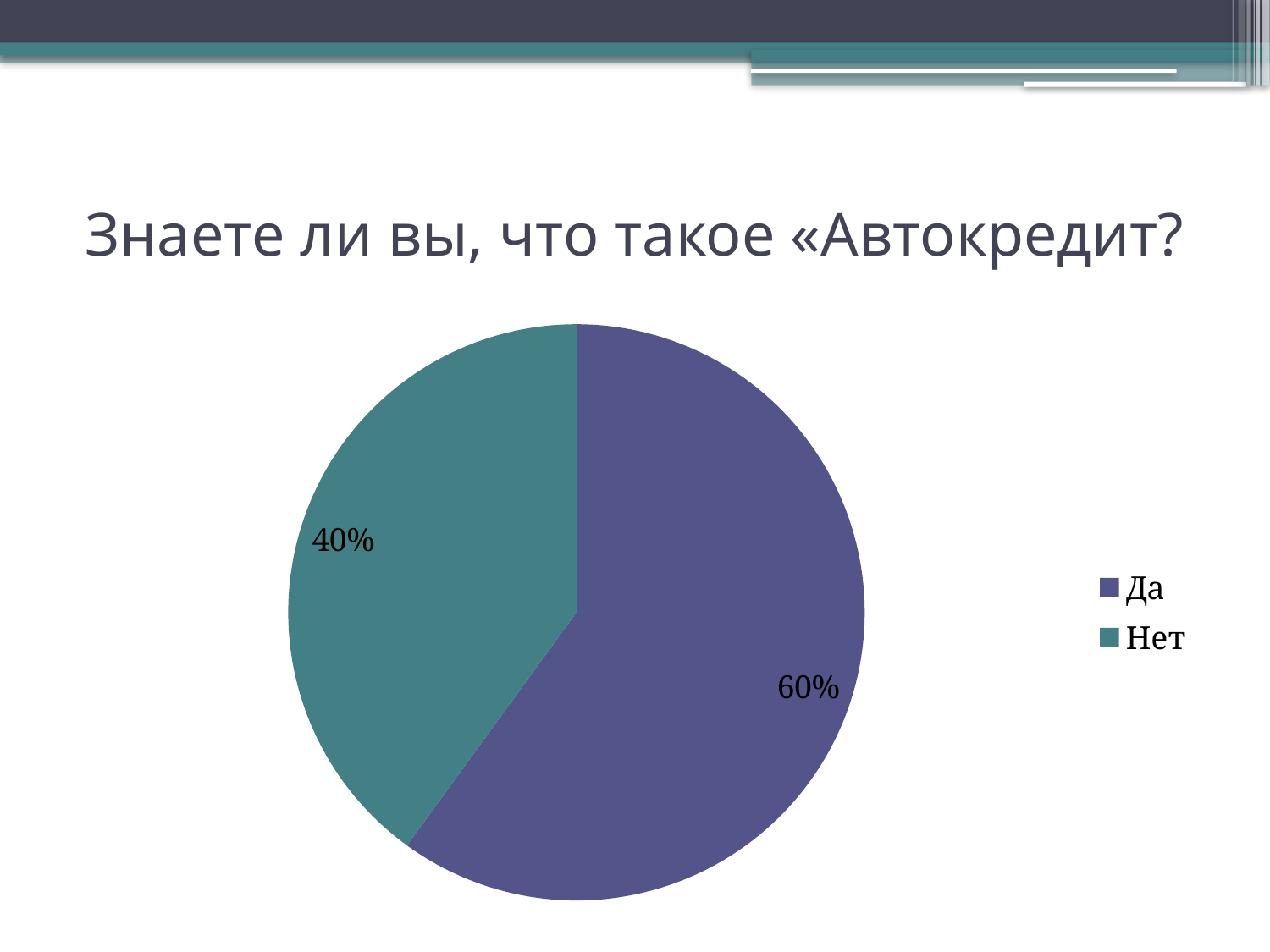
How many slices does the pie chart have? 2 What is the title of the slide above the chart? Знаете ли вы, что такое «Автокредит? Which category has the largest slice of the pie? Да What share of the pie does the "Нет" slice represent? 40% Which slice is larger, "Да" or "Нет"? Да Which category has the smallest slice of the pie? Нет What is the difference in percentage points between the "Да" and "Нет" slices? 20 What kind of chart is shown on the slide? pie chart What share of the pie does the "Да" slice represent? 60% Which legend entry is shown in the teal/green colour? Нет How many entries does the legend list? 2 Is the share for "Нет" greater or less than 50%? less